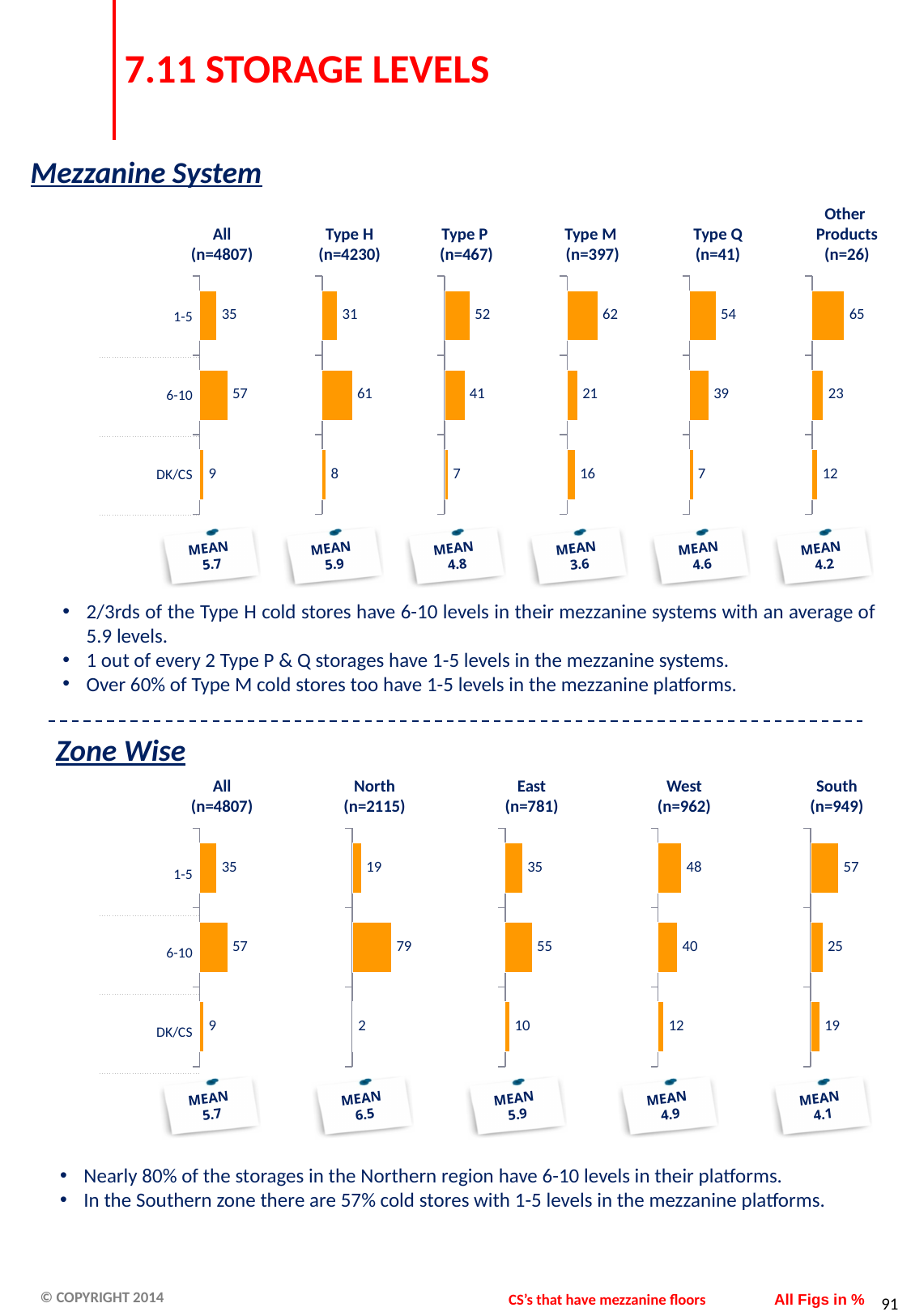
In the Mezzanine System charts, which group has the highest value for 1-5 levels? Other Products How many categories does each bar chart on the slide show? 3 In the Zone Wise charts, what is the difference between the 1-5 and 6-10 values for the South zone? 32 In the Zone Wise charts, what is the DK/CS value for the East zone? 10 In the Zone Wise charts, which zone has the lowest DK/CS value? North In the Mezzanine System charts, what is the mean number of levels for Type P? 4.8 In the Zone Wise charts, what is the value for 6-10 levels in the North zone? 79 What type of chart is used in the Mezzanine System section? Bar chart In the Mezzanine System charts, what percentage of Type H cold stores have 6-10 levels? 61 In the Zone Wise charts, for the West zone, which is larger: the 1-5 value or the 6-10 value? 1-5 In the Zone Wise charts, which zone has the highest mean? North In the Mezzanine System charts, what is the difference between the 1-5 and 6-10 values for Type M? 41